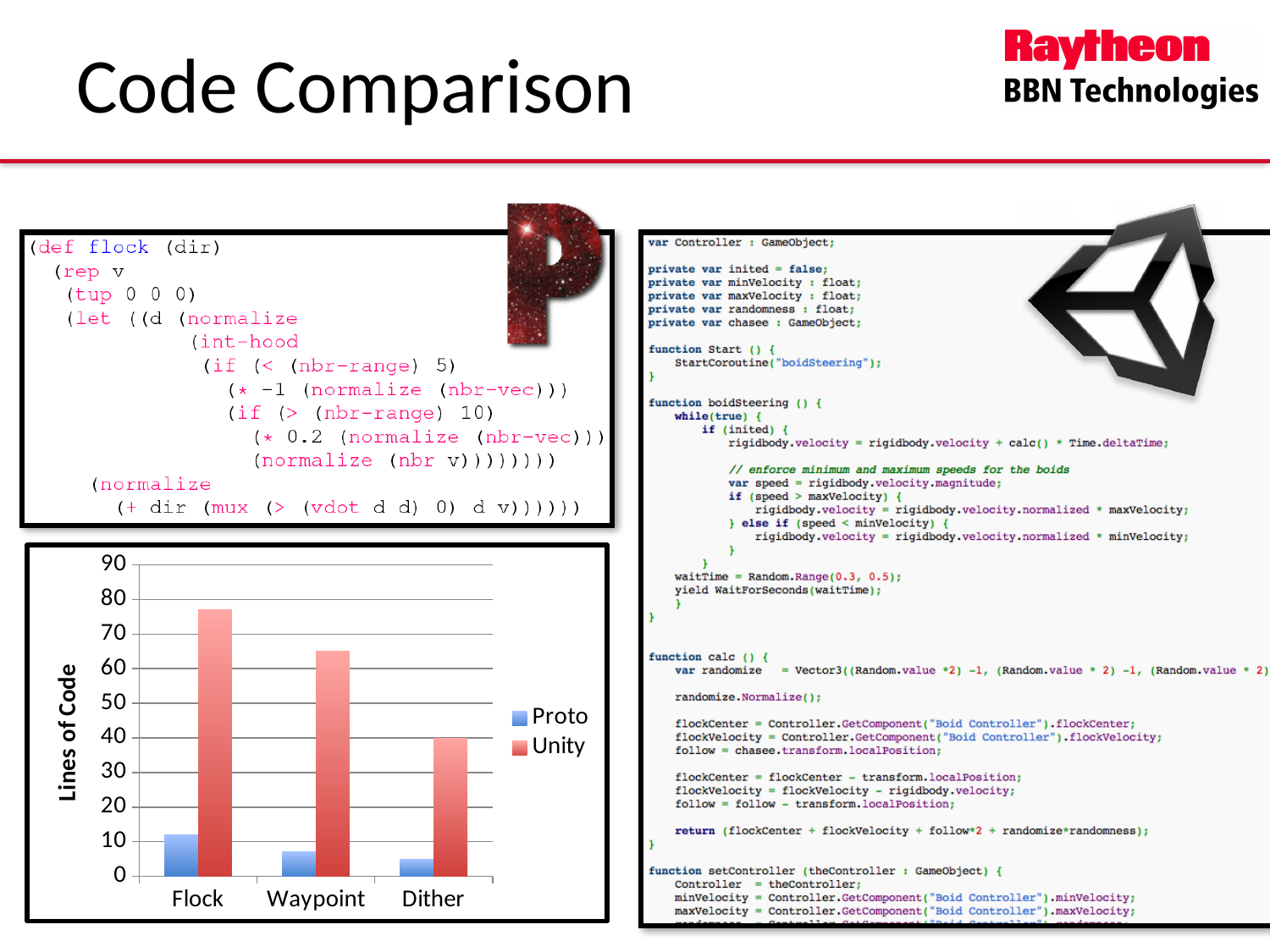
Do the Unity values rise or fall from Flock to Dither along the x axis? fall Is the Proto value for Flock greater or less than 10? greater Is the Unity value for Dither greater or less than 50? less For Flock, which series has the larger value, Proto or Unity? Unity What kind of chart is shown on the slide? bar chart How many series does the chart's legend list? 2 How many categories are shown on the x axis of the chart? 3 Which series is shown in red in the chart? Unity Which category has the highest Unity value? Flock Is the Unity value for Flock greater or less than 70? greater Which category has the lowest Proto value? Dither What is the title of the chart's vertical axis? Lines of Code